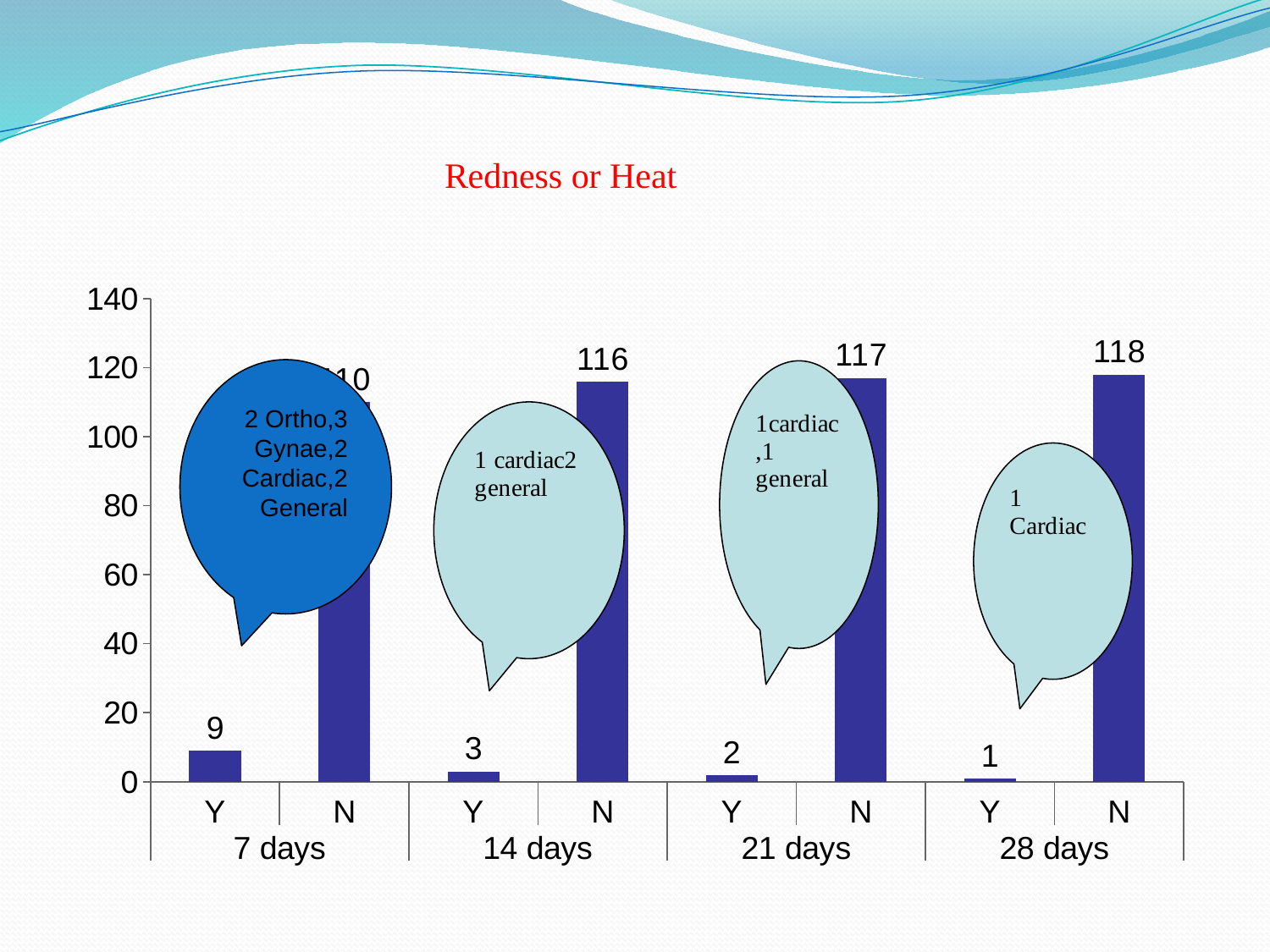
Which is larger, the Y value at 7 days or the Y value at 14 days? Y at 7 days What is the value for N at 14 days? 116 How many time-period groups are shown on the x axis? 4 Do the Y values rise or fall from 7 days to 28 days? fall What is the value for Y at 7 days? 9 What is the value for N at 28 days? 118 Which bar has the lowest value in the chart? Y at 28 days What is the value for Y at 21 days? 2 What is the difference between the N and Y values at 14 days? 113 What kind of chart is shown on the slide? bar chart Which bar has the highest value in the chart? N at 28 days Is the value for N at 7 days greater or less than 40? greater